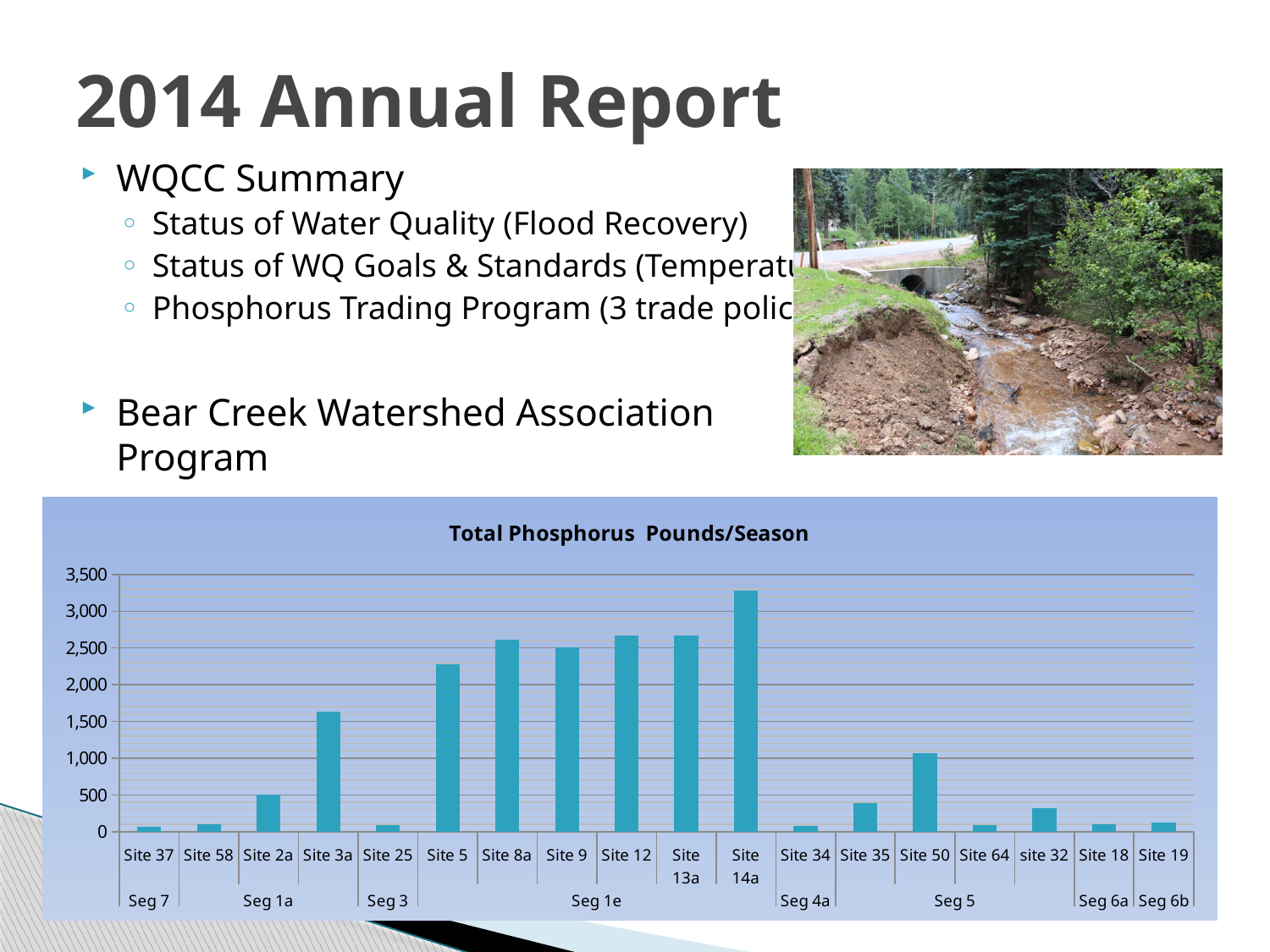
What type of chart is shown on the slide? Bar chart Is the value for Site 3a greater or less than 1,500? greater Which has a larger value, Site 3a or Site 50? Site 3a Is the value for Site 14a greater or less than 3,000? greater Which segment group on the x axis contains the most sites? Seg 1e Is the value for Site 50 greater or less than 500? greater Which has a larger value, Site 14a or Site 5? Site 14a How many sites are plotted in the chart? 18 What is the title of the chart? Total Phosphorus Pounds/Season Which site has the highest total phosphorus value in the chart? Site 14a